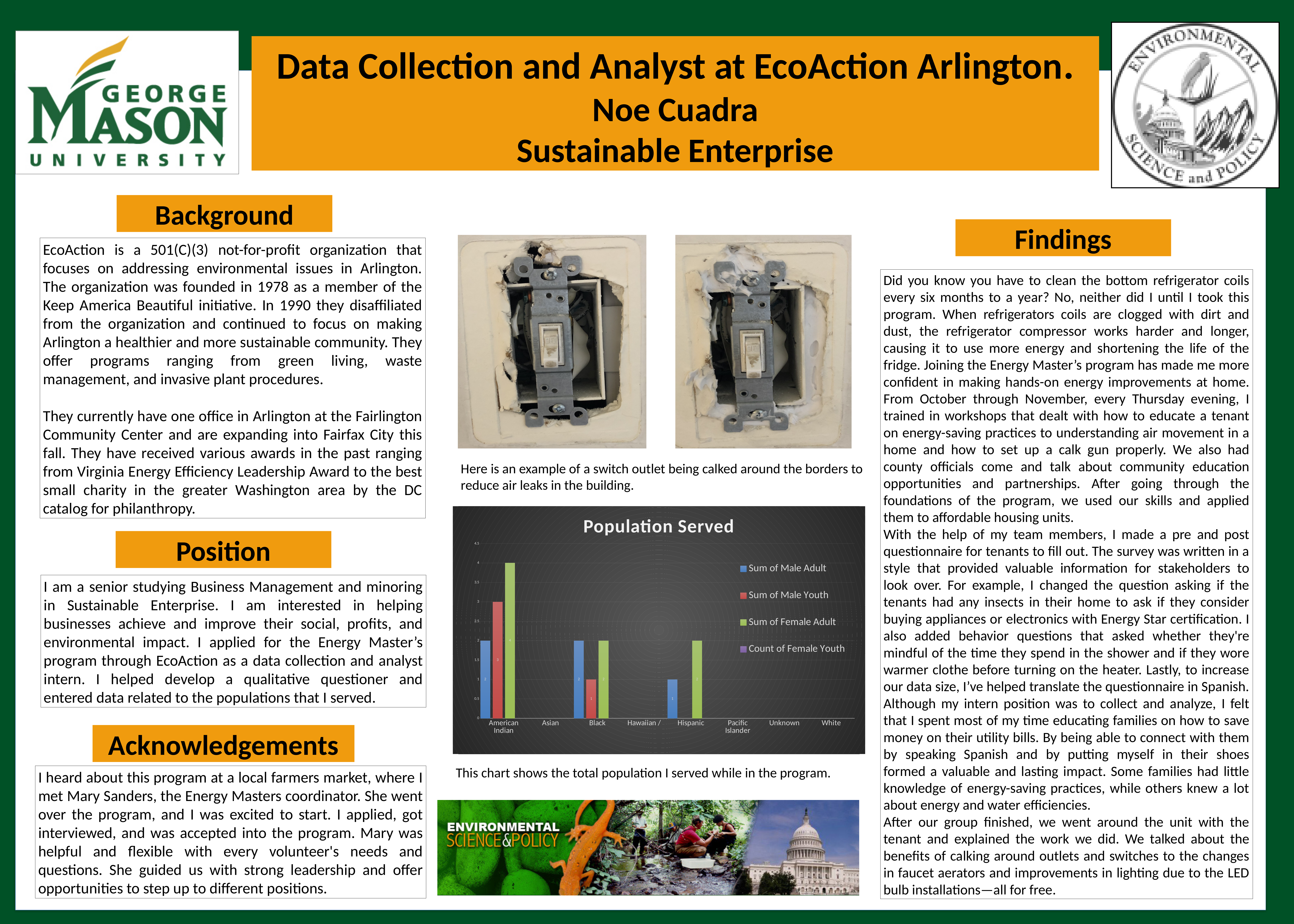
How many categories are shown on the x axis of the "Population Served" chart? 8 In the "Population Served" chart, which category has the highest Sum of Female Adult? American Indian What is the title of the chart on the slide? Population Served In the "Population Served" chart, what is the Sum of Male Youth for American Indian? 3 In the "Population Served" chart, what is the Sum of Female Adult for American Indian? 4 In the "Population Served" chart, what is the Sum of Male Adult for Hispanic? 1 In the "Population Served" chart, what is the Sum of Male Adult for Black? 2 In the "Population Served" chart, what is the difference between the Sum of Female Adult for American Indian and for Black? 2 What kind of chart is the "Population Served" chart? bar chart How many series does the legend of the "Population Served" chart list? 4 In the "Population Served" chart, what is the Sum of Male Youth for Black? 1 In the "Population Served" chart, which has the larger Sum of Male Youth, American Indian or Black? American Indian